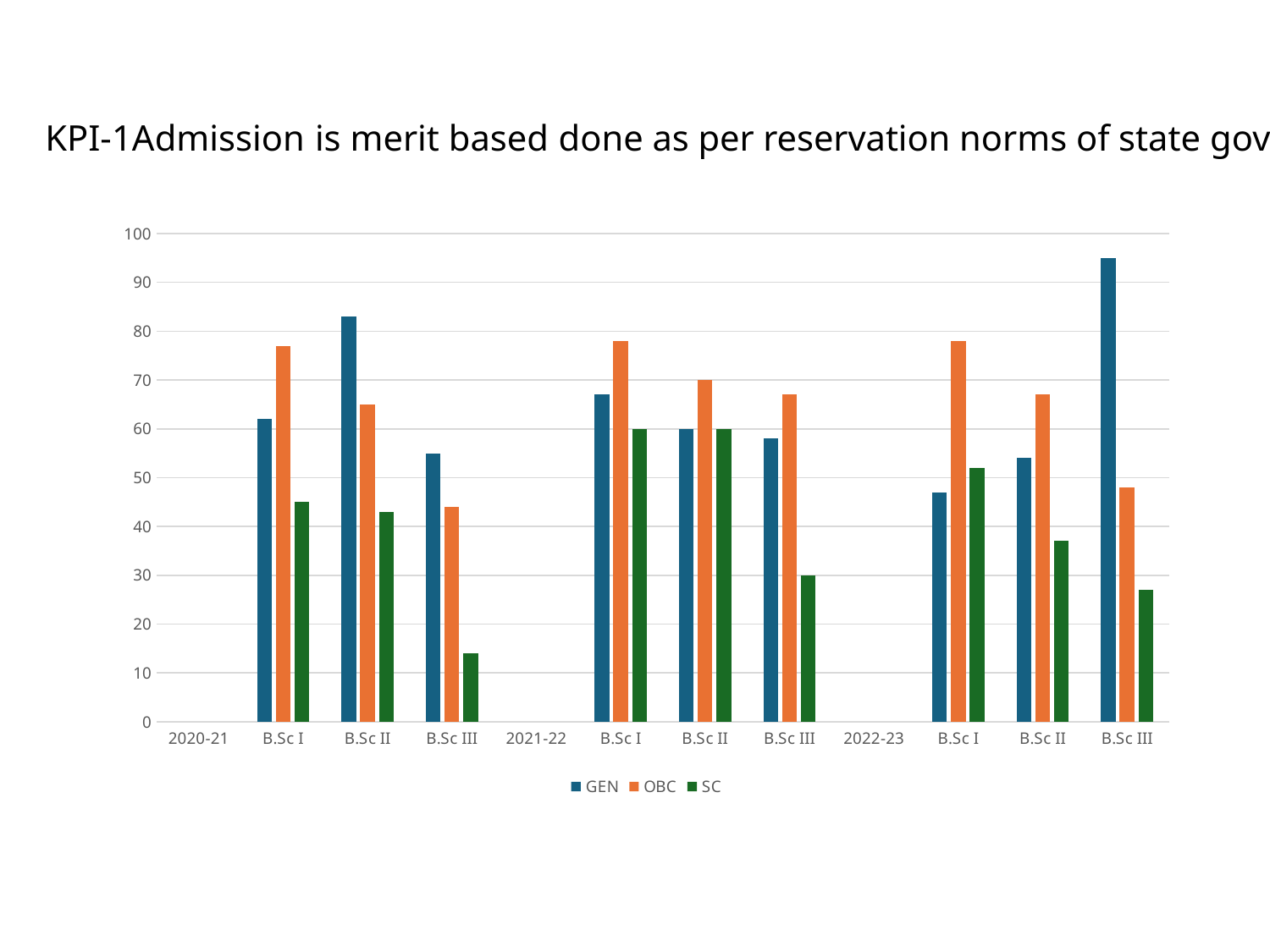
Which series has the tallest bar anywhere on the chart? GEN Is the GEN value for B.Sc III in 2022-23 greater or less than 90? greater For B.Sc III in 2022-23, which is larger, the GEN bar or the SC bar? GEN Which colour represents the OBC series in the legend? orange What kind of chart is shown on the slide? bar chart Is the SC value for B.Sc III in 2020-21 greater or less than 20? less Is the GEN value for B.Sc II in 2020-21 greater or less than 80? greater How many series does the legend list? 3 Do the SC values rise or fall from B.Sc I to B.Sc III in 2022-23? fall For B.Sc I in 2020-21, which is larger, the GEN bar or the OBC bar? OBC For which group is the GEN bar highest? B.Sc III (2022-23) For which group is the SC bar lowest? B.Sc III (2020-21)